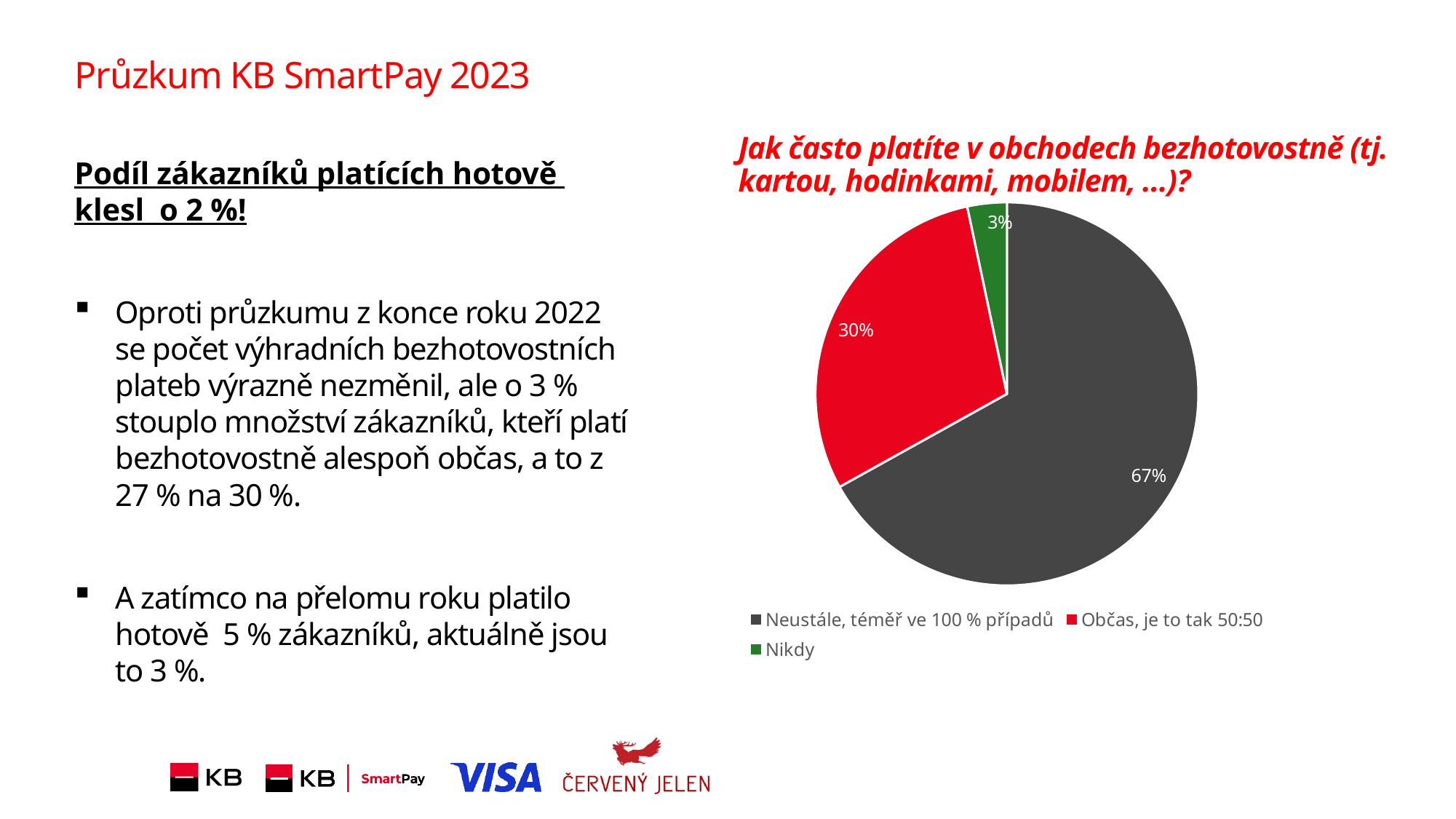
How many entries does the legend list? 3 What share of the pie is labelled "Občas, je to tak 50:50"? 30% Which category has the largest slice of the pie? Neustále, téměř ve 100 % případů What kind of chart is shown on the slide? pie chart What share of the pie is labelled "Neustále, téměř ve 100 % případů"? 67% What is the title of the pie chart? Jak často platíte v obchodech bezhotovostně (tj. kartou, hodinkami, mobilem, …)? What share of the pie is labelled "Nikdy"? 3% What is the difference in percentage points between the "Neustále, téměř ve 100 % případů" slice and the "Občas, je to tak 50:50" slice? 37 Which slice is larger: "Občas, je to tak 50:50" or "Nikdy"? Občas, je to tak 50:50 Which category has the smallest slice of the pie? Nikdy What colour is the "Nikdy" slice? green How many slices does the pie chart have? 3